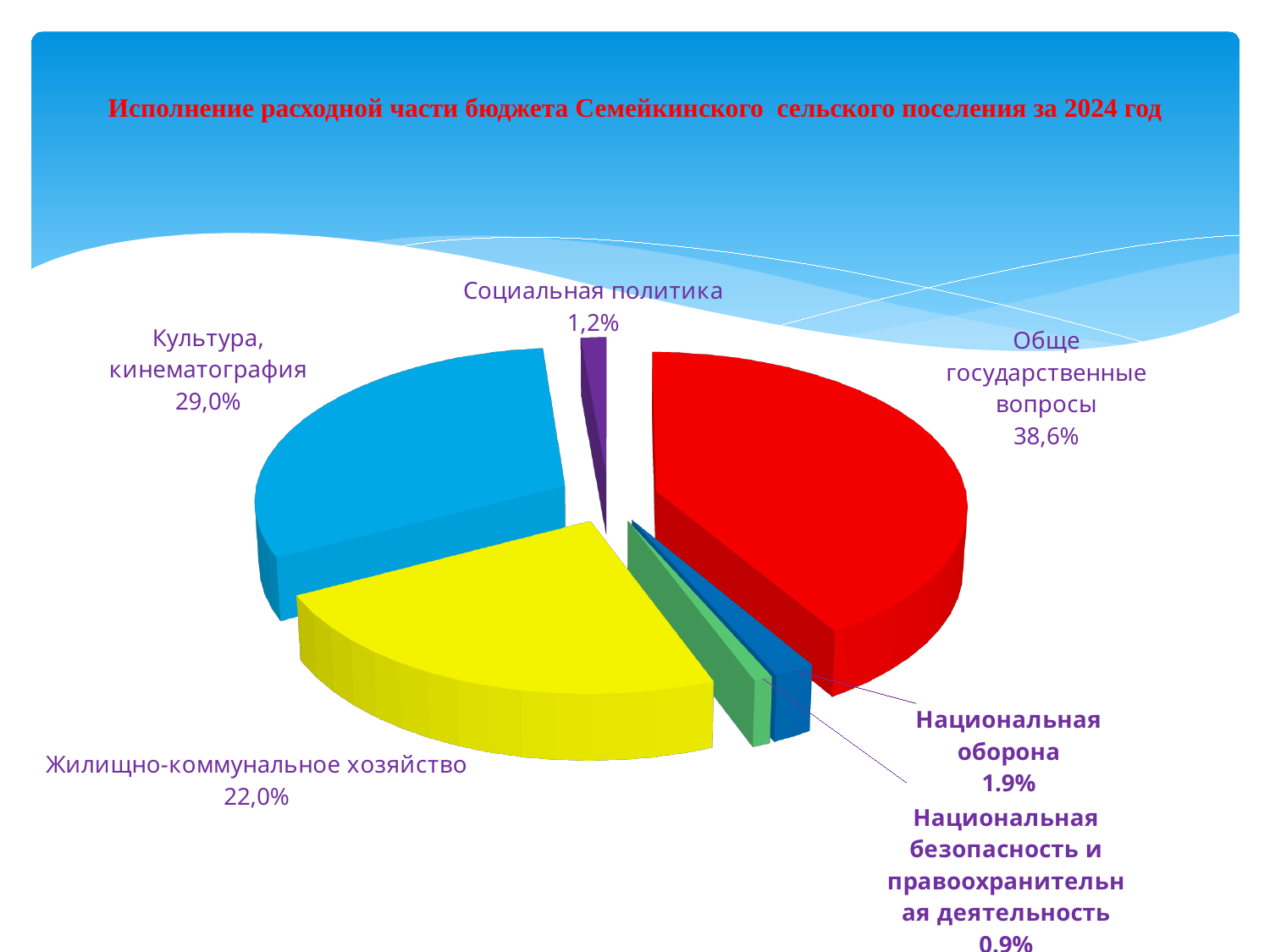
What share of the pie does Социальная политика have? 1,2% What share of the pie does Культура, кинематография have? 29,0% Which category has the largest share of the pie? Общегосударственные вопросы What share of the pie does Национальная безопасность и правоохранительная деятельность have? 0.9% What kind of chart is shown on the slide? Pie chart What share of the pie does Национальная оборона have? 1.9% Which is larger: the share for Жилищно-коммунальное хозяйство or the share for Культура, кинематография? Культура, кинематография What share of the pie does Общегосударственные вопросы have? 38,6% What is the difference in percentage points between Общегосударственные вопросы and Культура, кинематография? 9,6 Which category has the smallest share of the pie? Национальная безопасность и правоохранительная деятельность What share of the pie does Жилищно-коммунальное хозяйство have? 22,0% How many slices does the pie chart have? 6